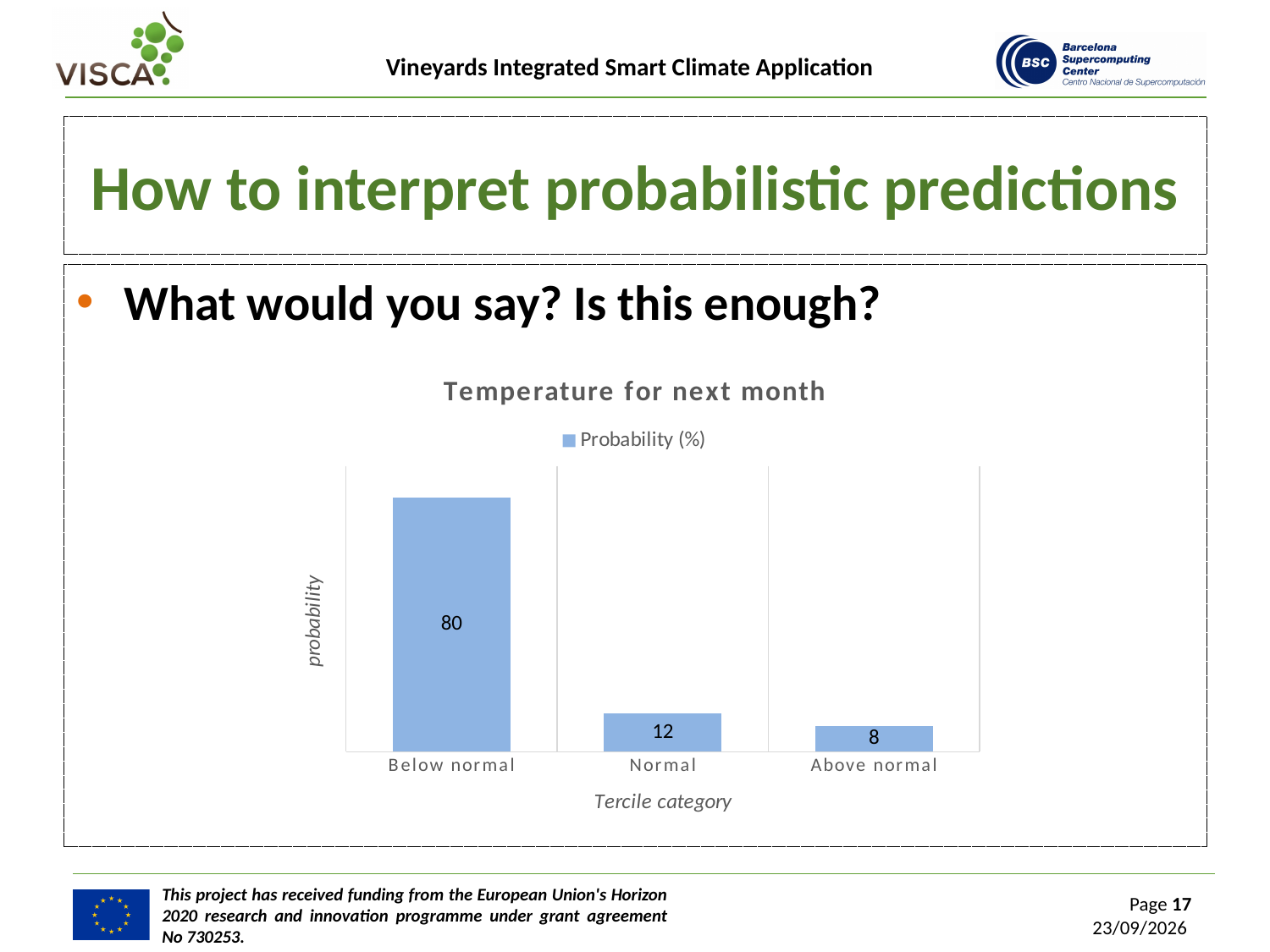
How many series does the legend list? 1 What is the difference between the probability for Normal and the probability for Above normal? 4 What is the difference between the probability for Below normal and the probability for Normal? 68 Which has a larger probability, Normal or Above normal? Normal Which tercile category has the highest probability? Below normal What is the probability value for the Below normal category? 80 What is the probability value for the Normal category? 12 Which tercile category has the lowest probability? Above normal What kind of chart is shown on the slide? Bar chart What is the probability value for the Above normal category? 8 How many tercile categories are shown in the chart? 3 What is the title of the chart? Temperature for next month